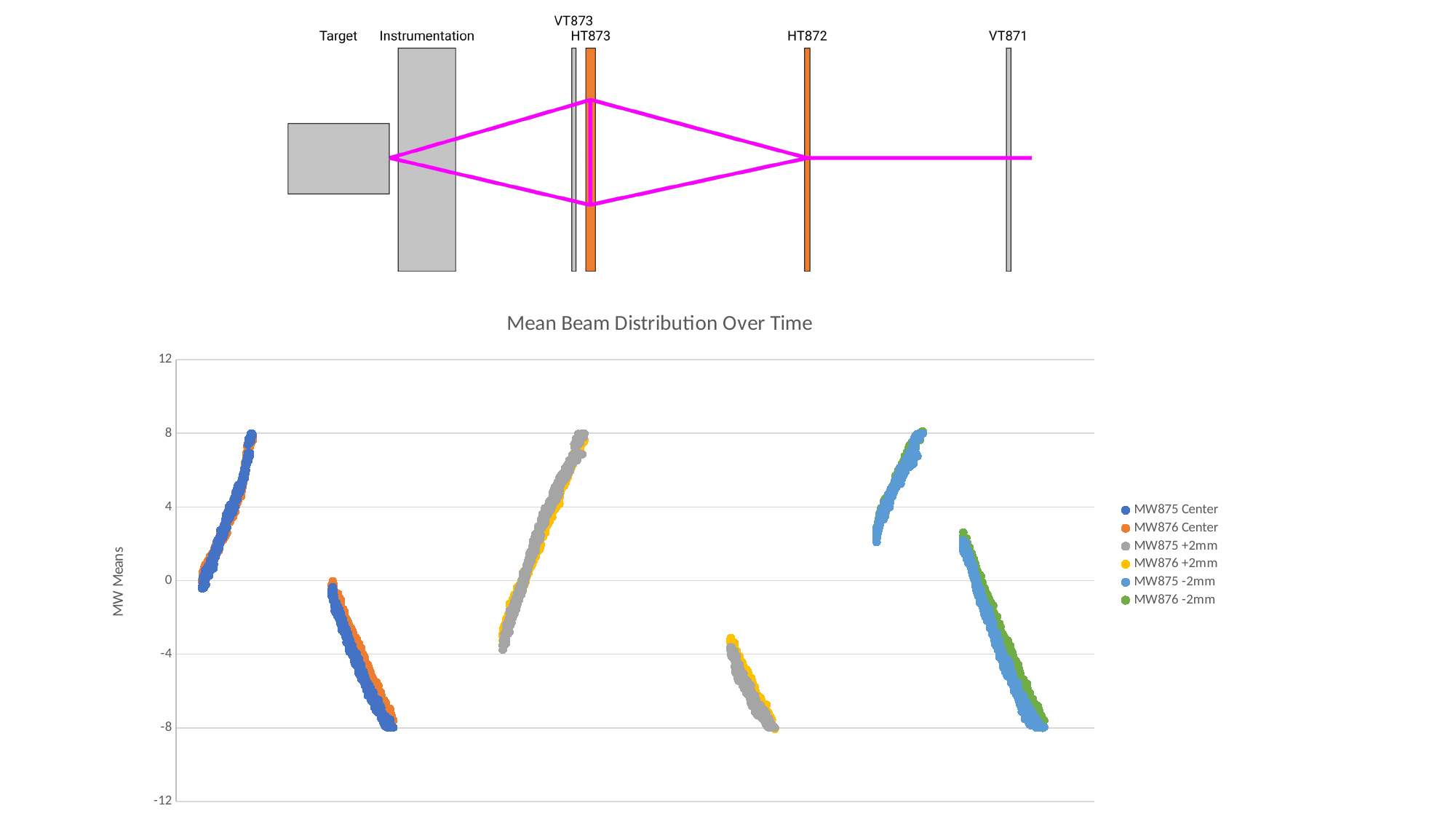
How many series does the legend of the "Mean Beam Distribution Over Time" chart list? 6 In the "Mean Beam Distribution Over Time" chart, is the lowest value reached by the MW875 -2mm series greater or less than -4? less What is the label on the vertical axis of the "Mean Beam Distribution Over Time" chart? MW Means In the "Mean Beam Distribution Over Time" chart, is the highest value reached by the MW876 -2mm series greater or less than 4? greater What kind of chart is shown under the title "Mean Beam Distribution Over Time"? scatter chart In the "Mean Beam Distribution Over Time" chart, is the highest value reached by the MW875 Center series greater or less than 4? greater What is the title of the chart on the slide? Mean Beam Distribution Over Time